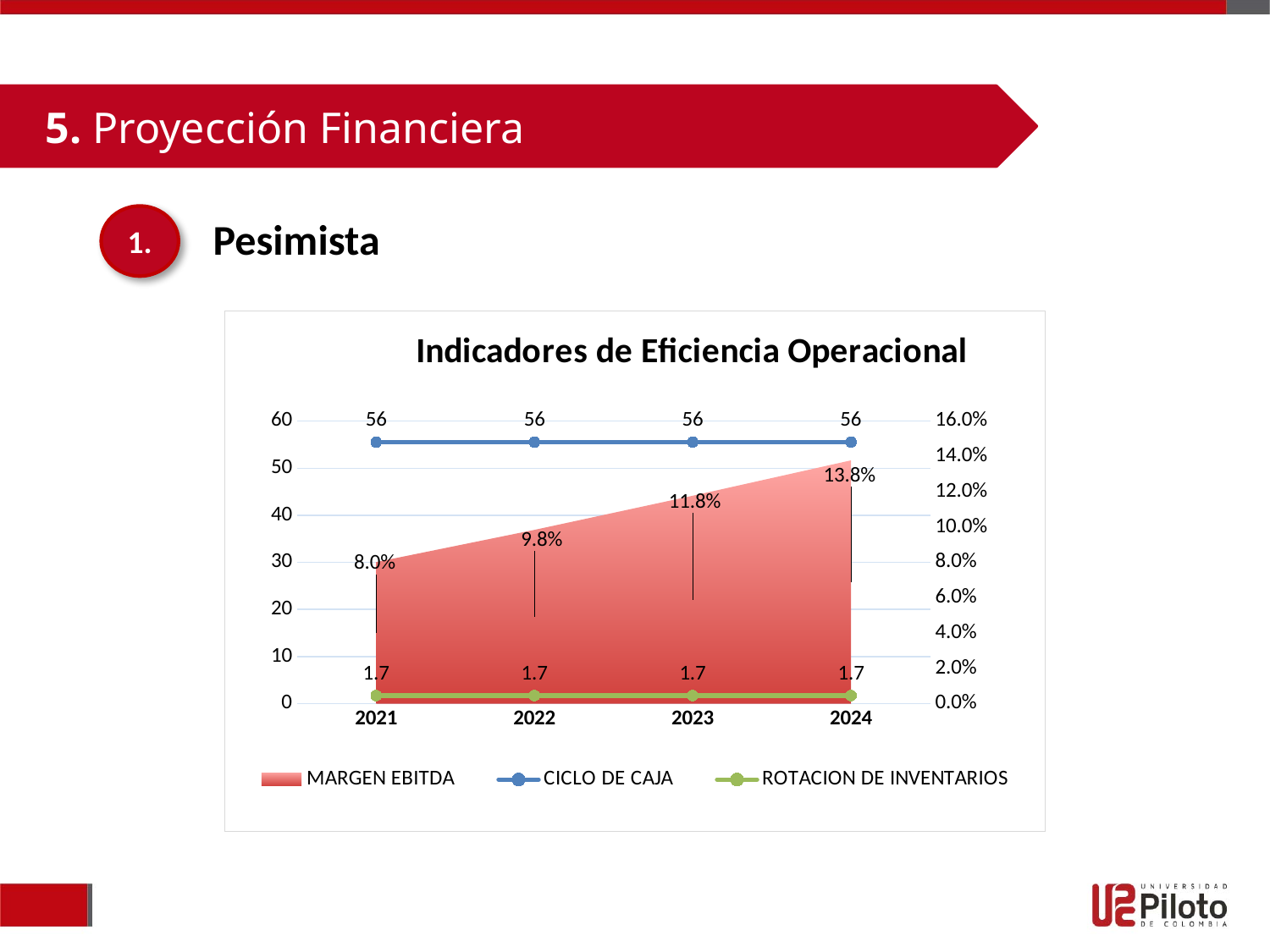
What is the difference between the MARGEN EBITDA values for 2024 and 2021? 5.8% How many years are shown on the x axis? 4 Does MARGEN EBITDA rise or fall from 2021 to 2024? rise How many series does the legend list? 3 In which year is MARGEN EBITDA highest? 2024 What is the MARGEN EBITDA value for 2024? 13.8% What is the CICLO DE CAJA value for 2023? 56 What is the ROTACION DE INVENTARIOS value for 2022? 1.7 Which is larger, the MARGEN EBITDA value for 2022 or for 2023? 2023 What is the MARGEN EBITDA value for 2021? 8.0% What is the title of the chart? Indicadores de Eficiencia Operacional In which year is MARGEN EBITDA lowest? 2021